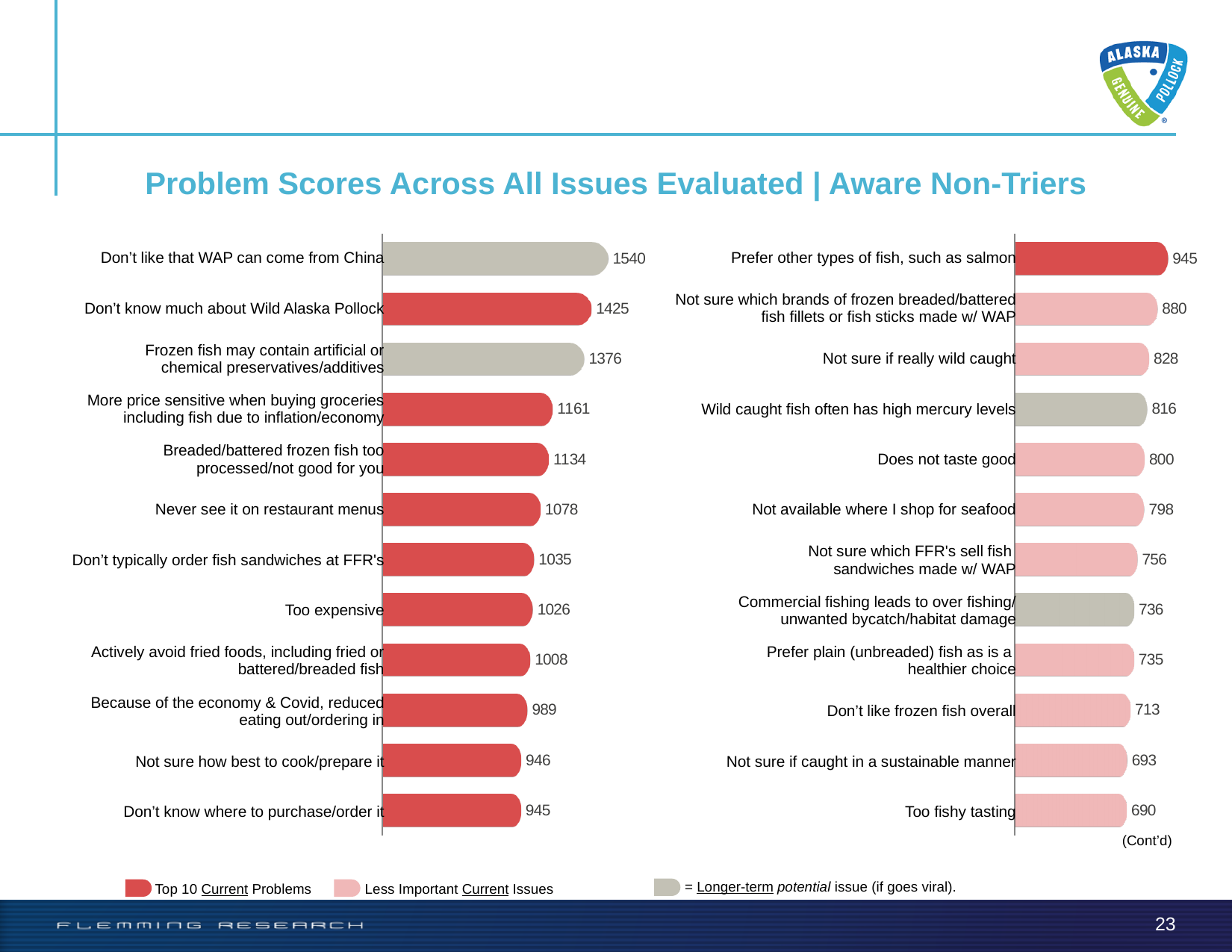
In the right chart, which issue has the highest problem score? Prefer other types of fish, such as salmon In the left chart, which issue has the lowest problem score? Don't know where to purchase/order it In the left chart, which has a higher score: "Never see it on restaurant menus" or "Not sure how best to cook/prepare it"? Never see it on restaurant menus In the right chart, which has a higher score: "Wild caught fish often has high mercury levels" or "Don't like frozen fish overall"? Wild caught fish often has high mercury levels What type of chart is used on this slide? Bar chart In the left chart, what is the problem score for "Don't like that WAP can come from China"? 1540 How many issues are plotted in the left chart? 12 How many categories does the legend at the bottom of the slide list? 3 In the right chart, what is the problem score for "Not sure if really wild caught"? 828 In the right chart, what is the difference between the scores for "Does not taste good" and "Too fishy tasting"? 110 In the right chart, what is the score for "Commercial fishing leads to over fishing/unwanted bycatch/habitat damage"? 736 In the left chart, what is the difference between the scores for "Don't know much about Wild Alaska Pollock" and "Too expensive"? 399